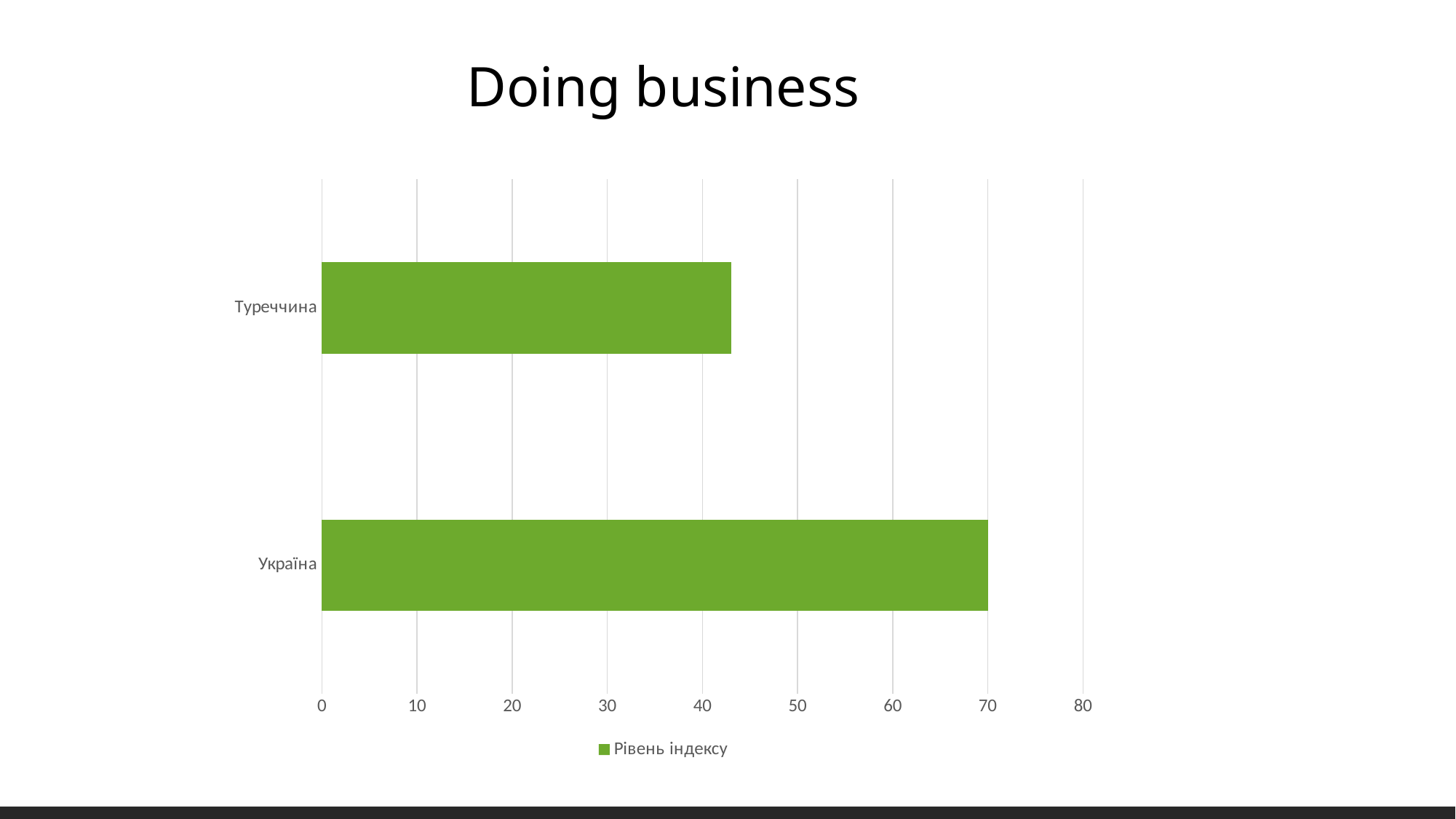
Which category has the highest value? Україна What is the title of the chart? Doing business What is the value for Україна? 70 Is the value for Туреччина greater or less than 40? greater What kind of chart is shown on the slide? bar chart What is the name of the series shown in the legend? Рівень індексу Which category has the lowest value? Туреччина How many series does the legend list? 1 Is the value for Туреччина greater or less than 50? less Is the value for Україна greater or less than 60? greater How many categories are plotted in the chart? 2 Which is larger, the value for Україна or the value for Туреччина? Україна